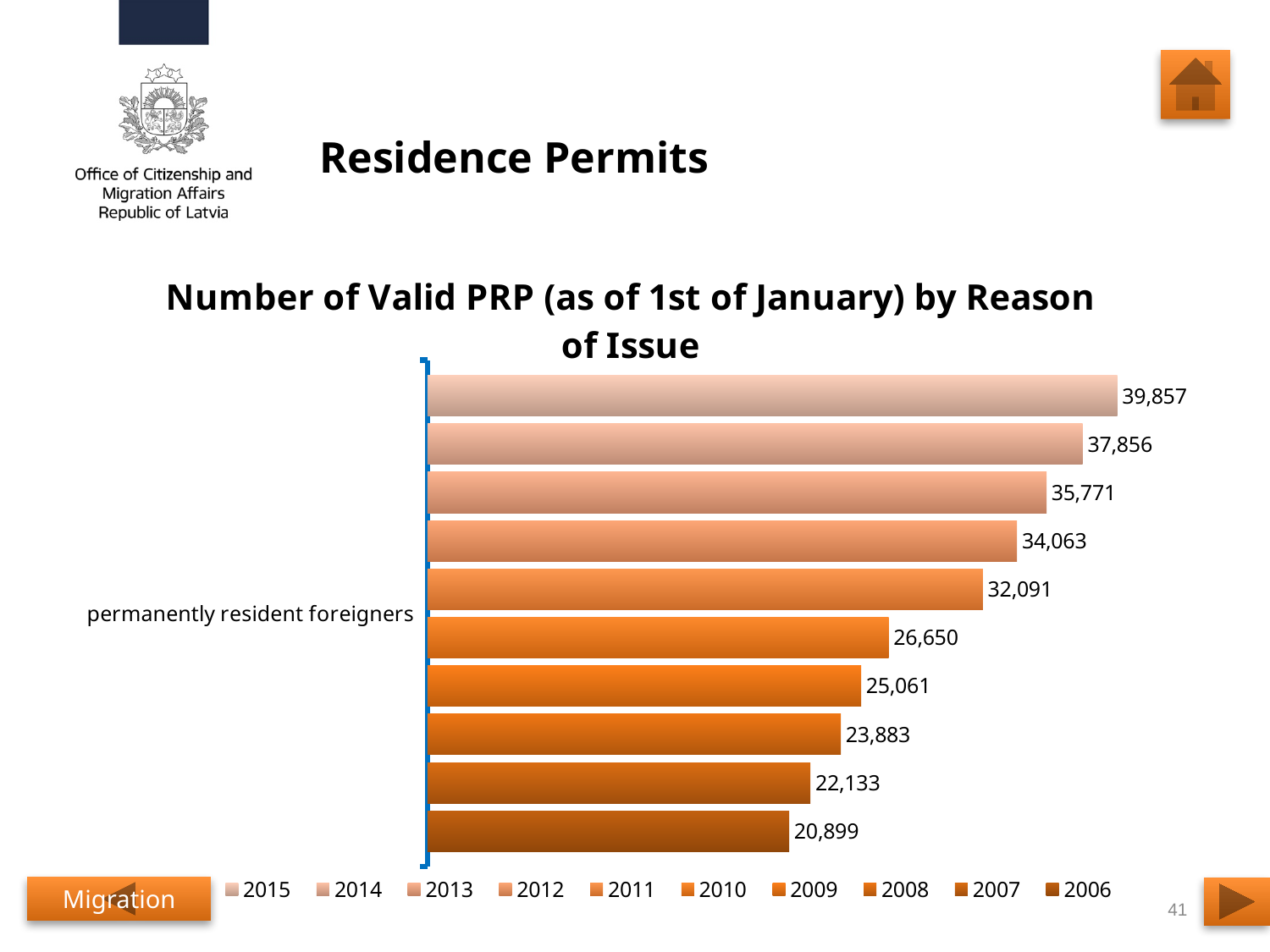
How many series does the legend list? 10 Which year has the highest number of valid PRP for permanently resident foreigners? 2015 What type of chart is shown on the slide? bar chart What is the number of valid PRP for permanently resident foreigners in 2012? 34,063 What is the difference between the 2011 and 2010 values for permanently resident foreigners? 5,441 What is the number of valid PRP for permanently resident foreigners in 2015? 39,857 What is the difference between the 2015 and 2014 values for permanently resident foreigners? 2,001 Which is larger, the value for 2009 or the value for 2008? 2009 Which year has the lowest number of valid PRP for permanently resident foreigners? 2006 What is the number of valid PRP for permanently resident foreigners in 2006? 20,899 What is the title of the chart? Number of Valid PRP (as of 1st of January) by Reason of Issue What is the number of valid PRP for permanently resident foreigners in 2010? 26,650